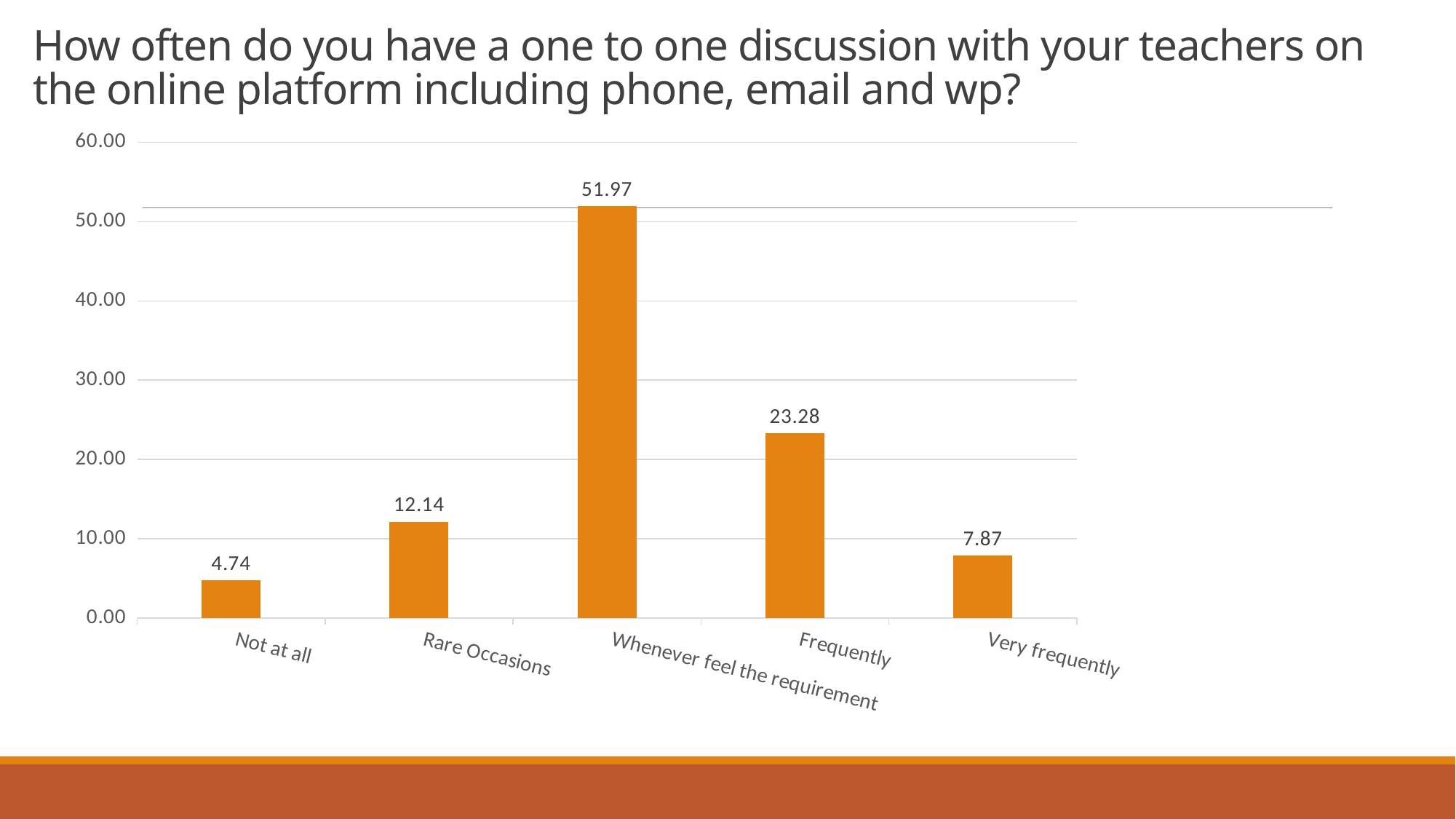
What is the value for "Very frequently"? 7.87 Which category has the lowest value? Not at all What is the value for "Frequently"? 23.28 What is the difference between the values for "Whenever feel the requirement" and "Frequently"? 28.69 Which category has the highest value? Whenever feel the requirement How many categories are shown on the x axis? 5 What kind of chart is shown on the slide? Bar chart What is the value for "Rare Occasions"? 12.14 What is the value for "Whenever feel the requirement"? 51.97 What is the value for "Not at all"? 4.74 Which is larger, the value for "Rare Occasions" or the value for "Very frequently"? Rare Occasions Is the value for "Frequently" greater or less than 20.00? greater